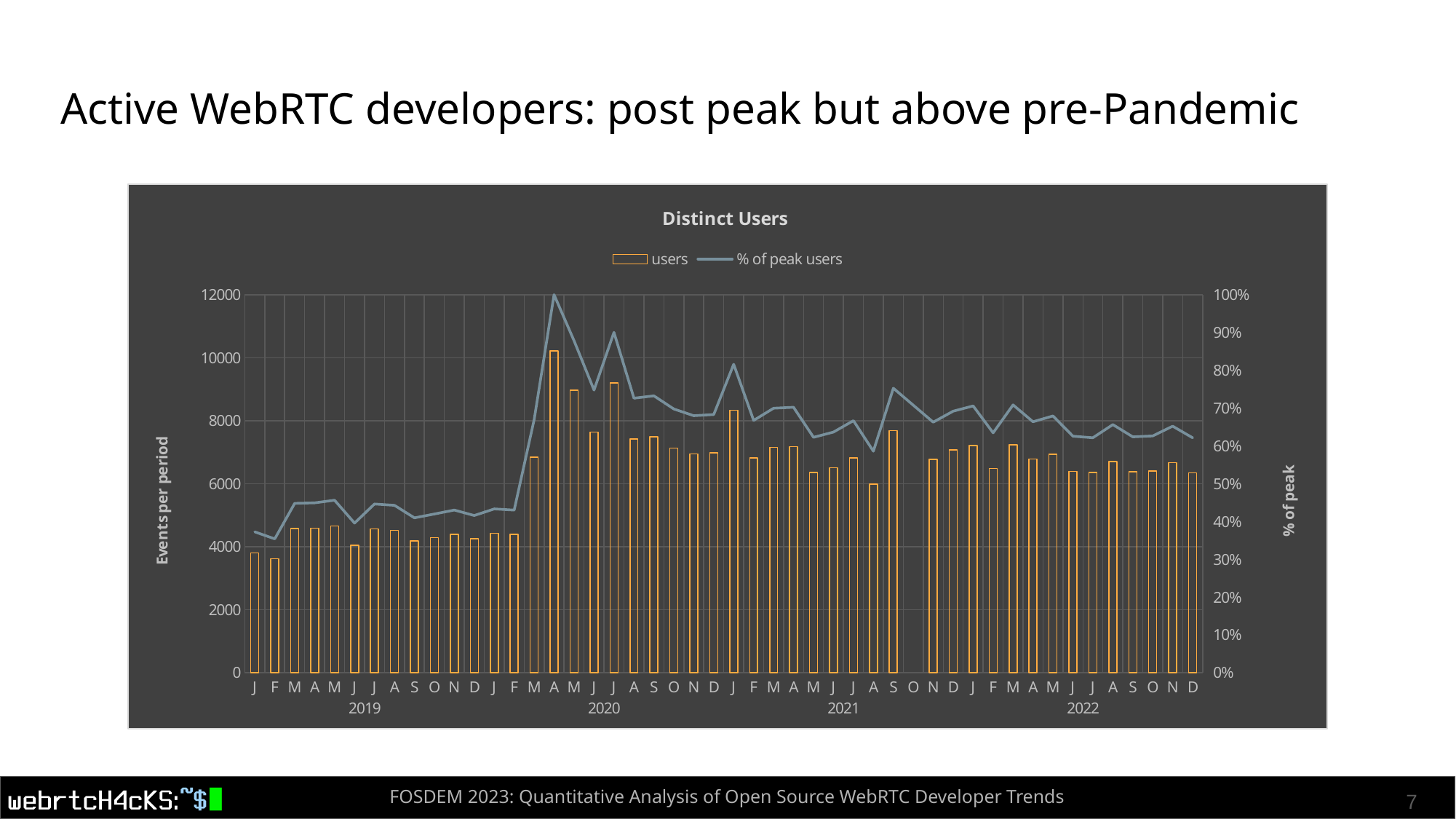
What is the title of the chart? Distinct Users From April 2020 to December 2020, do the users values generally rise or fall? fall Is the users value for February 2019 greater or less than 4000? less Is the users value for April 2020 greater or less than 8000? greater How many series does the chart legend list? 2 What kind of chart is shown on the slide? A combined bar and line chart In which month does the users bar reach its highest value? April 2020 Which has more users, January 2020 or January 2021? January 2021 What is the label of the left vertical axis? Events per period What is the % of peak users value for April 2020? 100% Is the users value for December 2022 greater or less than 6000? greater How many years are labelled along the x axis? 4